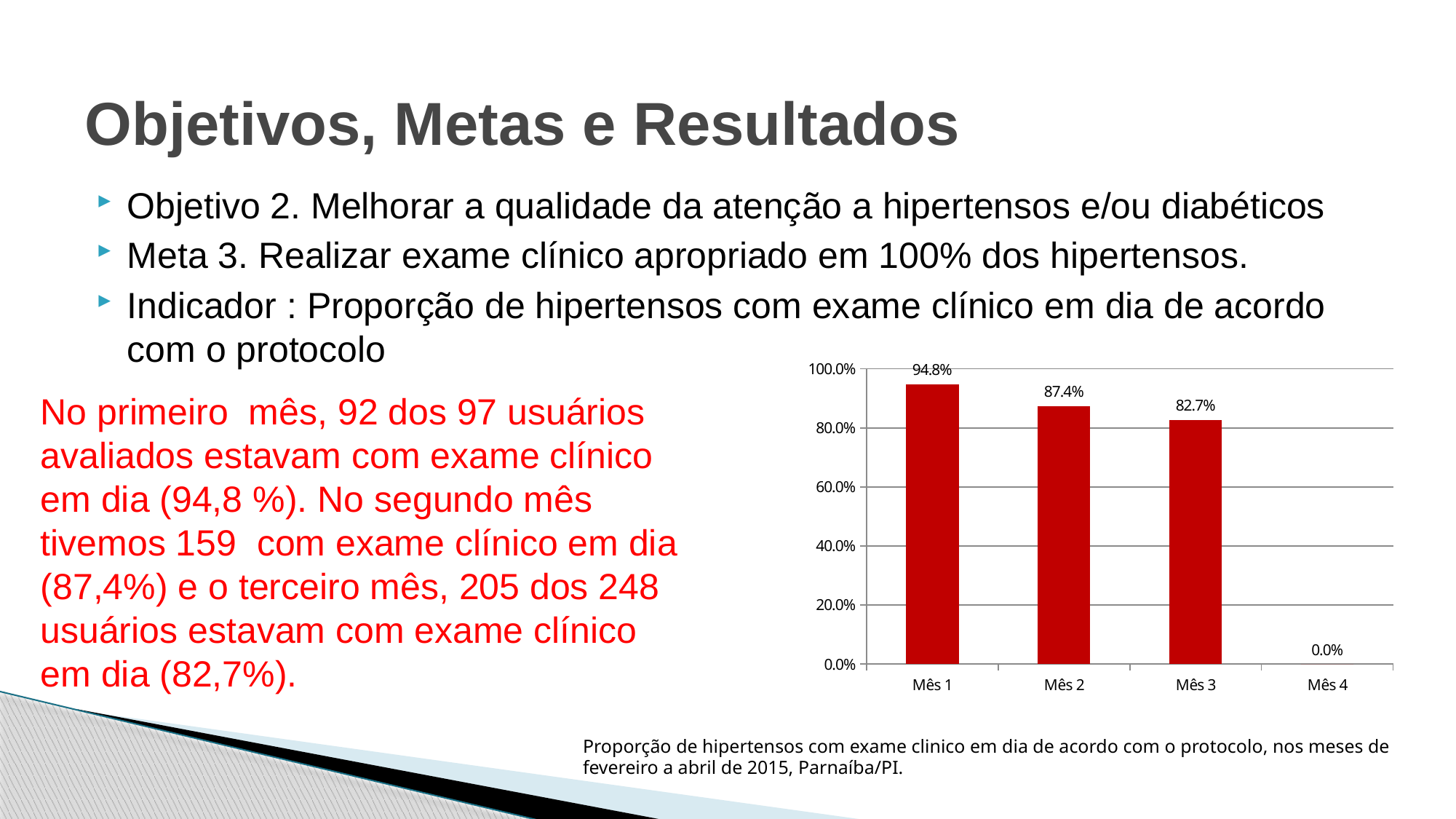
What is the value for Mês 4? 0.0% What kind of chart is shown on the slide? Bar chart What is the value for Mês 1? 94.8% How many categories are shown on the x axis? 4 Which month has the highest value? Mês 1 What is the difference between the values for Mês 1 and Mês 3? 12.1% What is the value for Mês 2? 87.4% Which is larger, the value for Mês 2 or the value for Mês 3? Mês 2 What is the value for Mês 3? 82.7% Which month has the lowest value? Mês 4 Do the values rise or fall from Mês 1 to Mês 3? Fall What is the difference between the values for Mês 1 and Mês 2? 7.4%